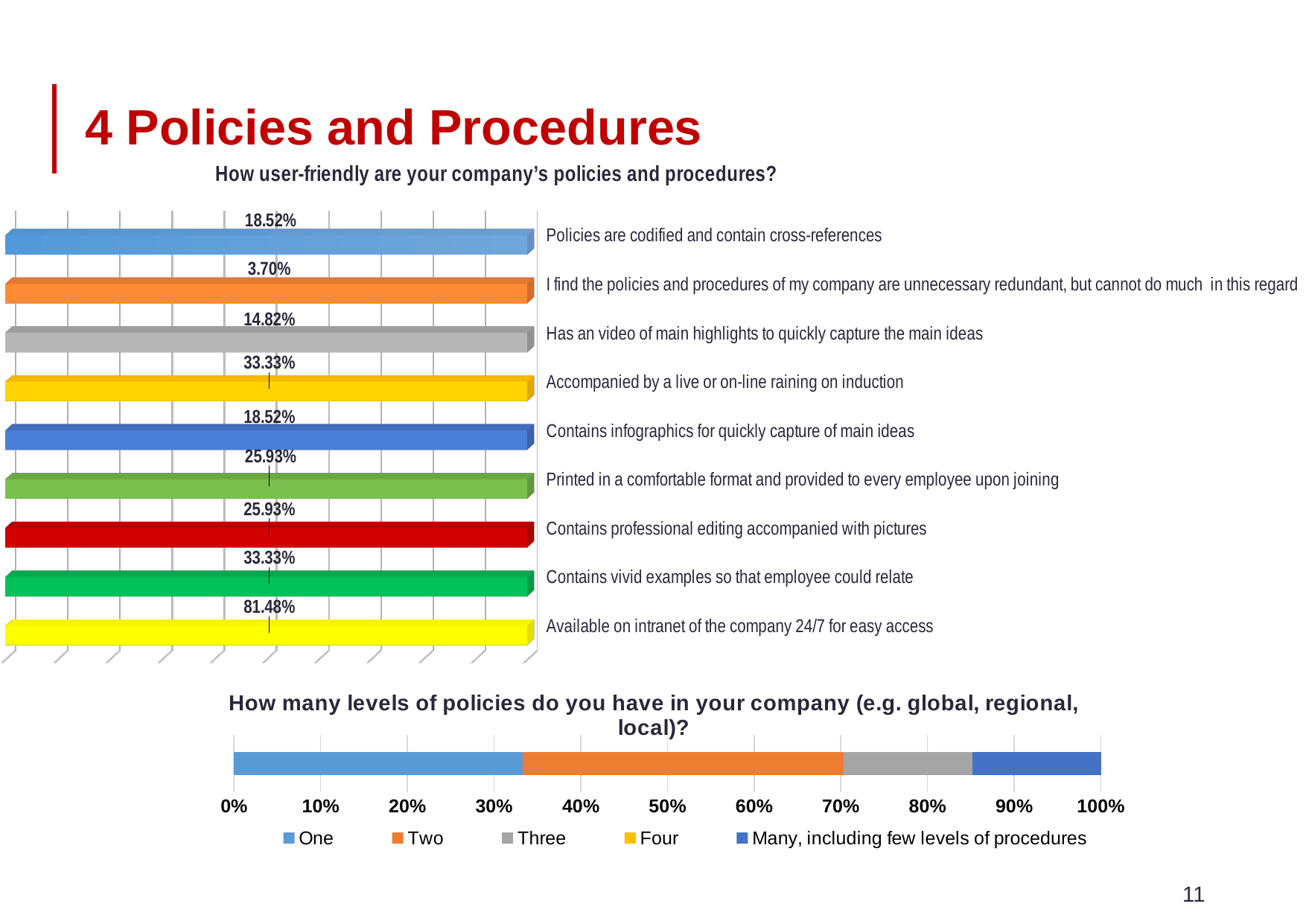
What kind of chart is 'How many levels of policies do you have in your company (e.g. global, regional, local)?'? Stacked bar chart In the chart 'How user-friendly are your company's policies and procedures?', what is the value for 'Contains professional editing accompanied with pictures'? 25.93% In the chart 'How user-friendly are your company's policies and procedures?', which category has the highest value? Available on intranet of the company 24/7 for easy access In the chart 'How user-friendly are your company's policies and procedures?', what is the value for 'Available on intranet of the company 24/7 for easy access'? 81.48% In the chart 'How many levels of policies do you have in your company (e.g. global, regional, local)?', is the share for 'Two' greater or less than 30%? greater How many categories are shown in the chart 'How user-friendly are your company's policies and procedures?'? 9 In the chart 'How user-friendly are your company's policies and procedures?', what is the value for 'Has an video of main highlights to quickly capture the main ideas'? 14.82% In the chart 'How user-friendly are your company's policies and procedures?', what is the difference between the values for 'Available on intranet of the company 24/7 for easy access' and 'Contains vivid examples so that employee could relate'? 48.15% In the chart 'How user-friendly are your company's policies and procedures?', which is larger: 'Accompanied by a live or on-line raining on induction' or 'Contains infographics for quickly capture of main ideas'? Accompanied by a live or on-line raining on induction In the chart 'How many levels of policies do you have in your company (e.g. global, regional, local)?', is the share for 'Three' greater or less than 20%? less How many series does the legend list in the chart 'How many levels of policies do you have in your company (e.g. global, regional, local)?'? 5 In the chart 'How user-friendly are your company's policies and procedures?', which category has the lowest value? I find the policies and procedures of my company are unnecessary redundant, but cannot do much in this regard